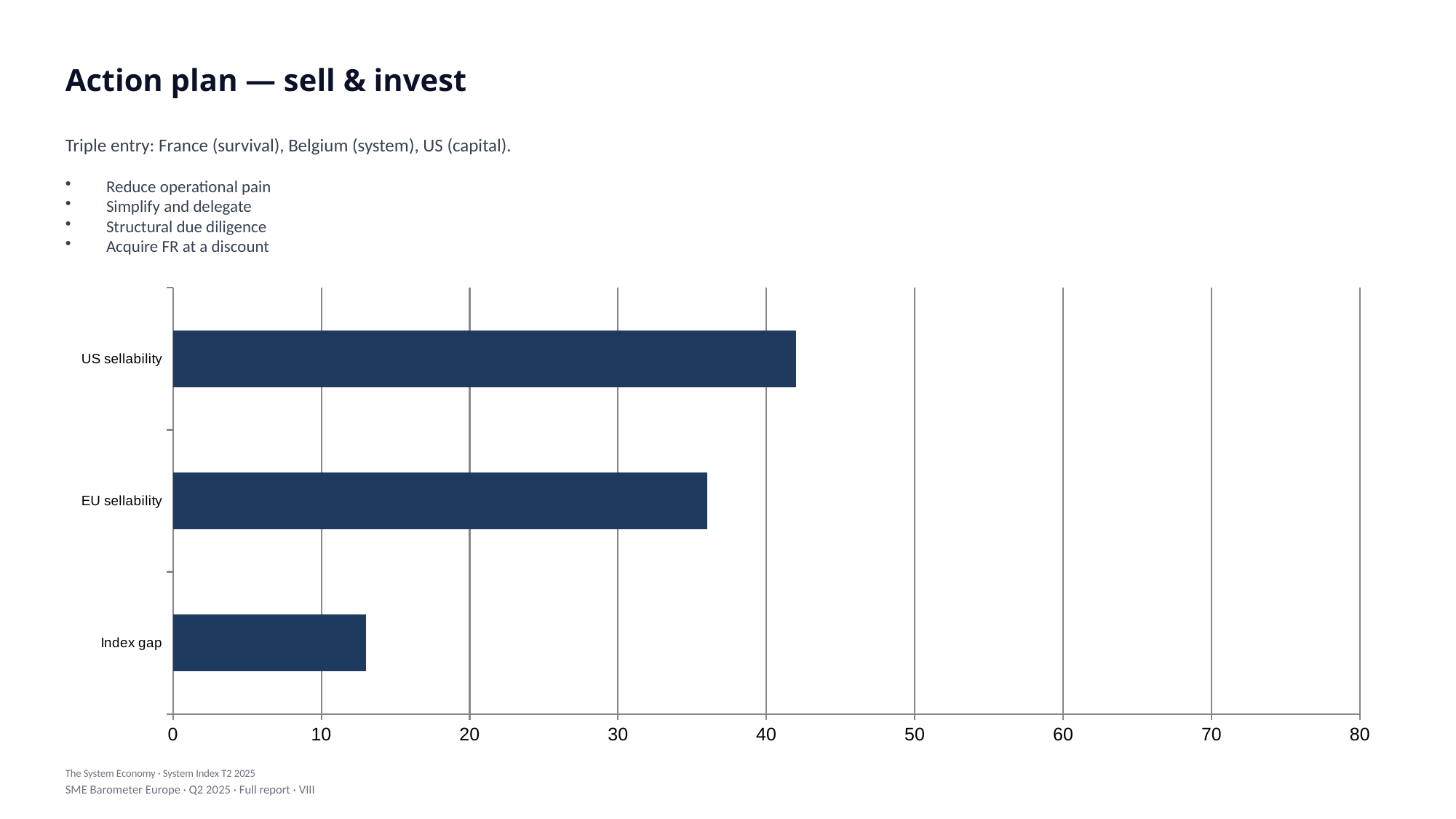
How many categories are plotted in the chart? 3 Which category has the lowest value in the chart? Index gap Is the value for Index gap greater or less than 20? less Is the value for EU sellability greater or less than 40? less Is the value for US sellability greater or less than 40? greater What kind of chart is shown on the slide? bar chart Which is larger, the value for EU sellability or the value for Index gap? EU sellability What is the maximum value shown on the horizontal axis of the chart? 80 Which is larger, the value for US sellability or the value for EU sellability? US sellability Which category has the highest value in the chart? US sellability